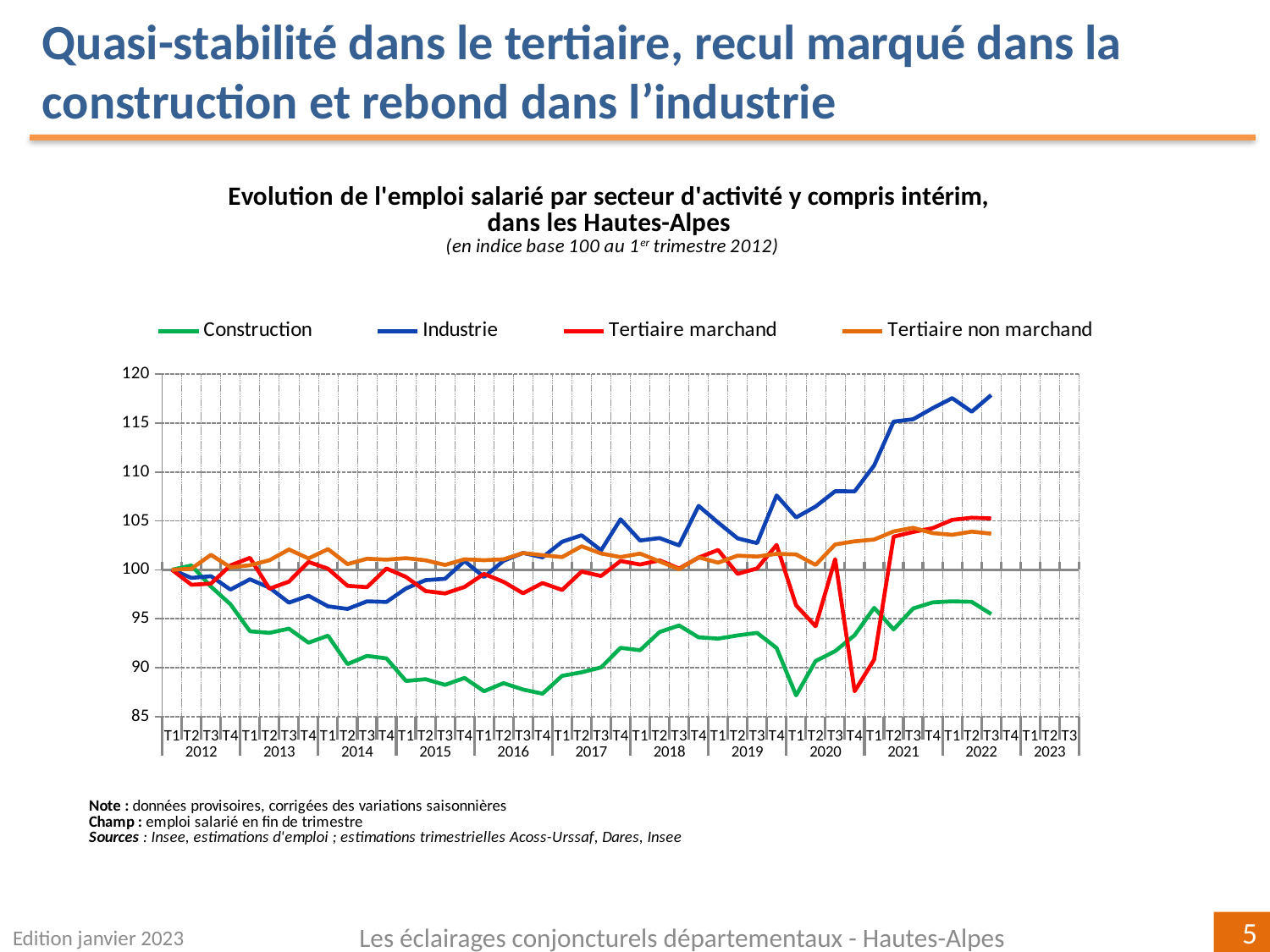
Which series are listed in the legend? Construction, Industrie, Tertiaire marchand, Tertiaire non marchand What colour is the Industrie line? blue Which series has the lowest value at T3 2022? Construction Does the Industrie line rise or fall between T1 2020 and T3 2022? rise Which series has the highest value at T3 2022? Industrie Is the value for Tertiaire non marchand at T3 2022 greater or less than 105? less At T3 2022, which is larger: Industrie or Construction? Industrie Is the value for Tertiaire marchand at T4 2020 greater or less than 90? less Is the value for Construction at T1 2020 greater or less than 90? less What kind of chart is shown on the slide? line chart How many series does the legend list? 4